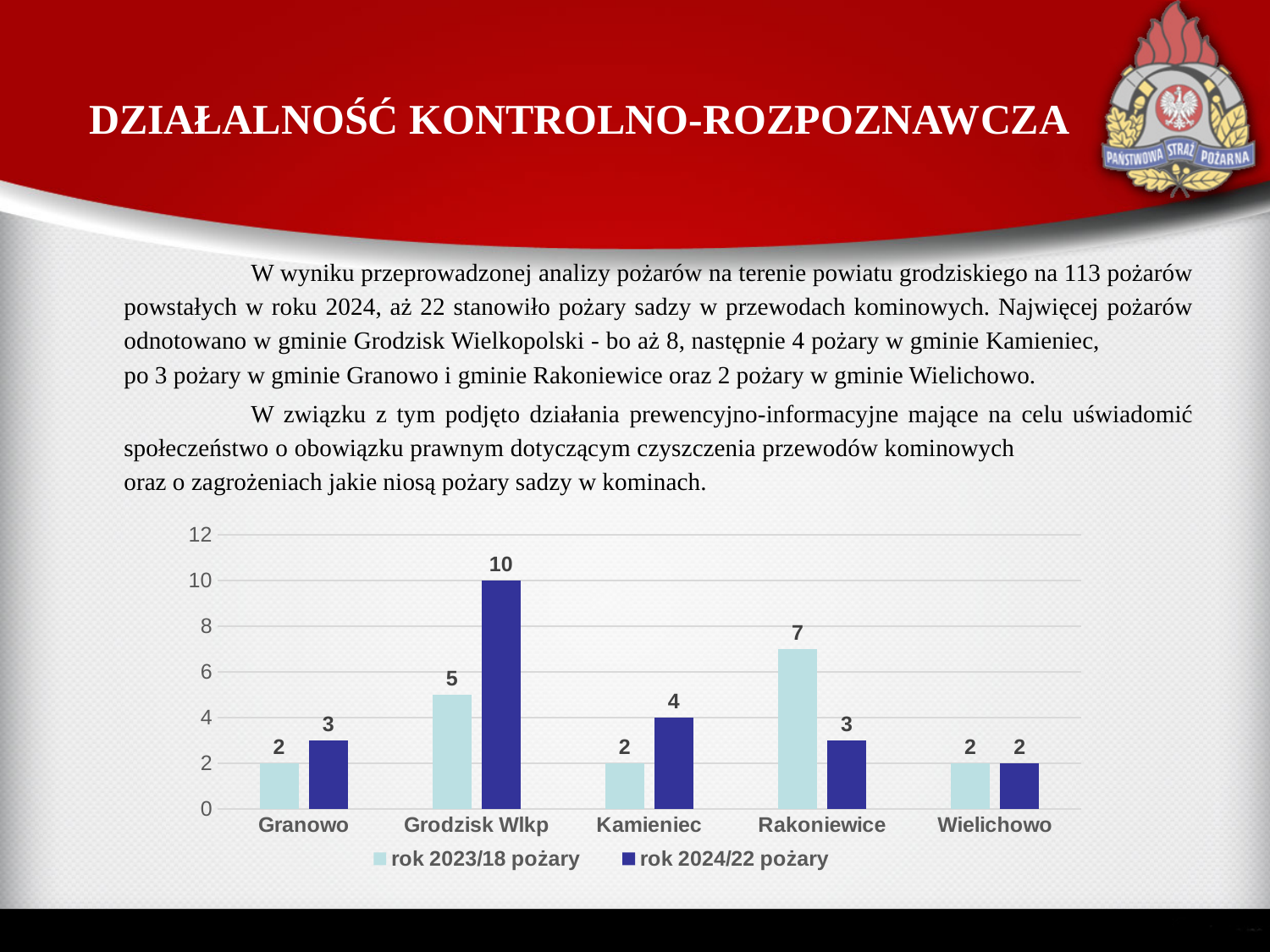
What is the value for Grodzisk Wlkp in the "rok 2024/22 pożary" series? 10 What is the difference between the "rok 2023/18 pożary" and "rok 2024/22 pożary" values for Rakoniewice? 4 Which category has the same value in both series? Wielichowo How many series does the chart legend list? 2 What is the value for Rakoniewice in the "rok 2023/18 pożary" series? 7 Which category has the highest value in the "rok 2023/18 pożary" series? Rakoniewice How many categories are shown on the x axis of the chart? 5 What kind of chart is shown on the slide? bar chart Which category has the highest value in the "rok 2024/22 pożary" series? Grodzisk Wlkp What is the value for Kamieniec in the "rok 2024/22 pożary" series? 4 What is the difference between the "rok 2024/22 pożary" and "rok 2023/18 pożary" values for Grodzisk Wlkp? 5 Which is larger for Kamieniec: the "rok 2023/18 pożary" value or the "rok 2024/22 pożary" value? rok 2024/22 pożary